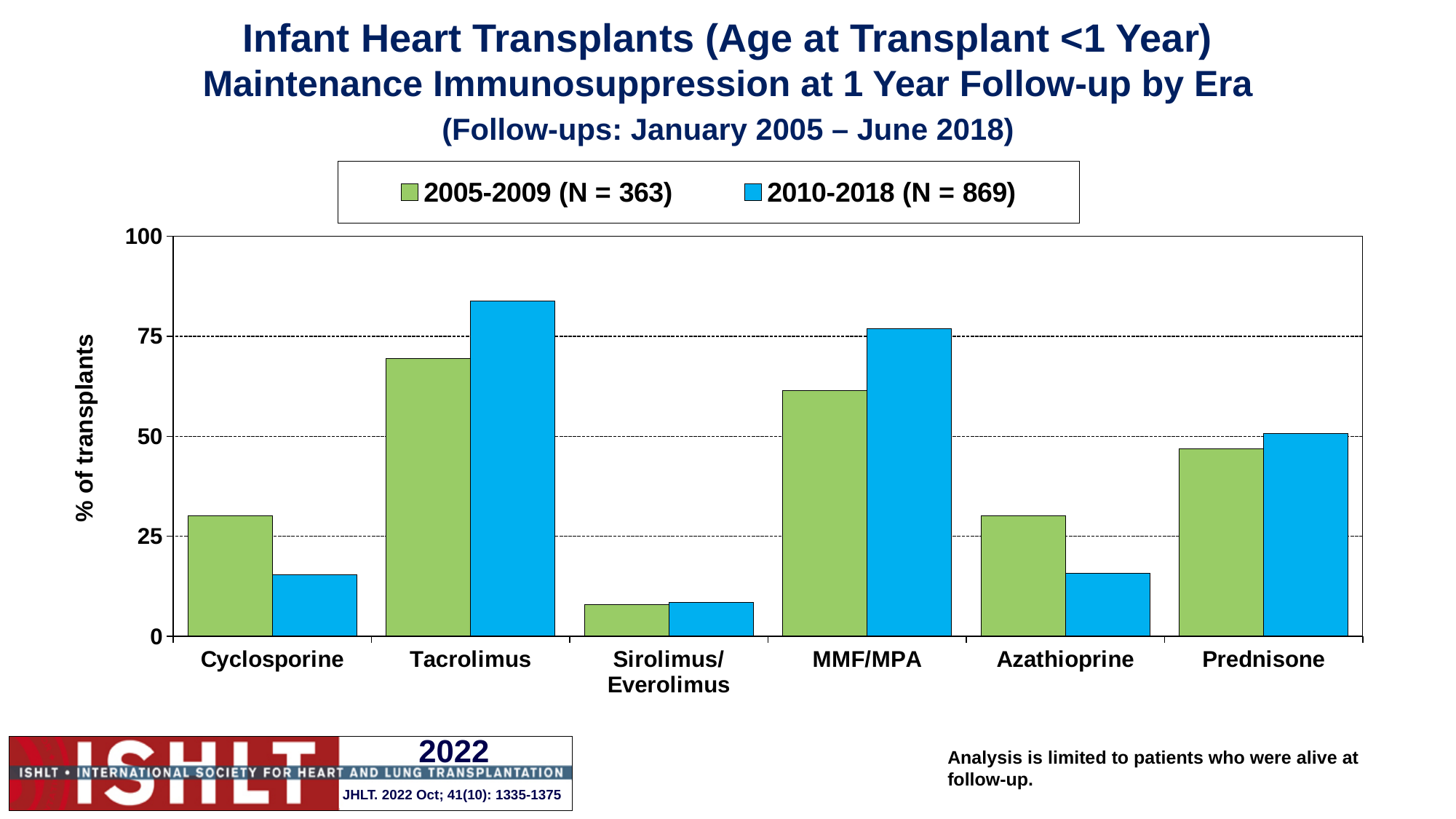
For Cyclosporine, which era has the larger value, 2005-2009 or 2010-2018? 2005-2009 Is the value for Azathioprine in 2010-2018 greater or less than 25? less How many drug categories are shown on the x axis? 6 For MMF/MPA, which era has the larger value, 2005-2009 or 2010-2018? 2010-2018 What kind of chart is shown on the slide? bar chart What is the N shown in the legend for the 2010-2018 series? 869 Which drug has the lowest value for the 2005-2009 series? Sirolimus/Everolimus Is the value for MMF/MPA in 2005-2009 greater or less than 50? greater Which drug has the highest value for the 2010-2018 series? Tacrolimus What is the label on the y axis? % of transplants How many series does the legend list? 2 Is the value for Tacrolimus in 2010-2018 greater or less than 75? greater